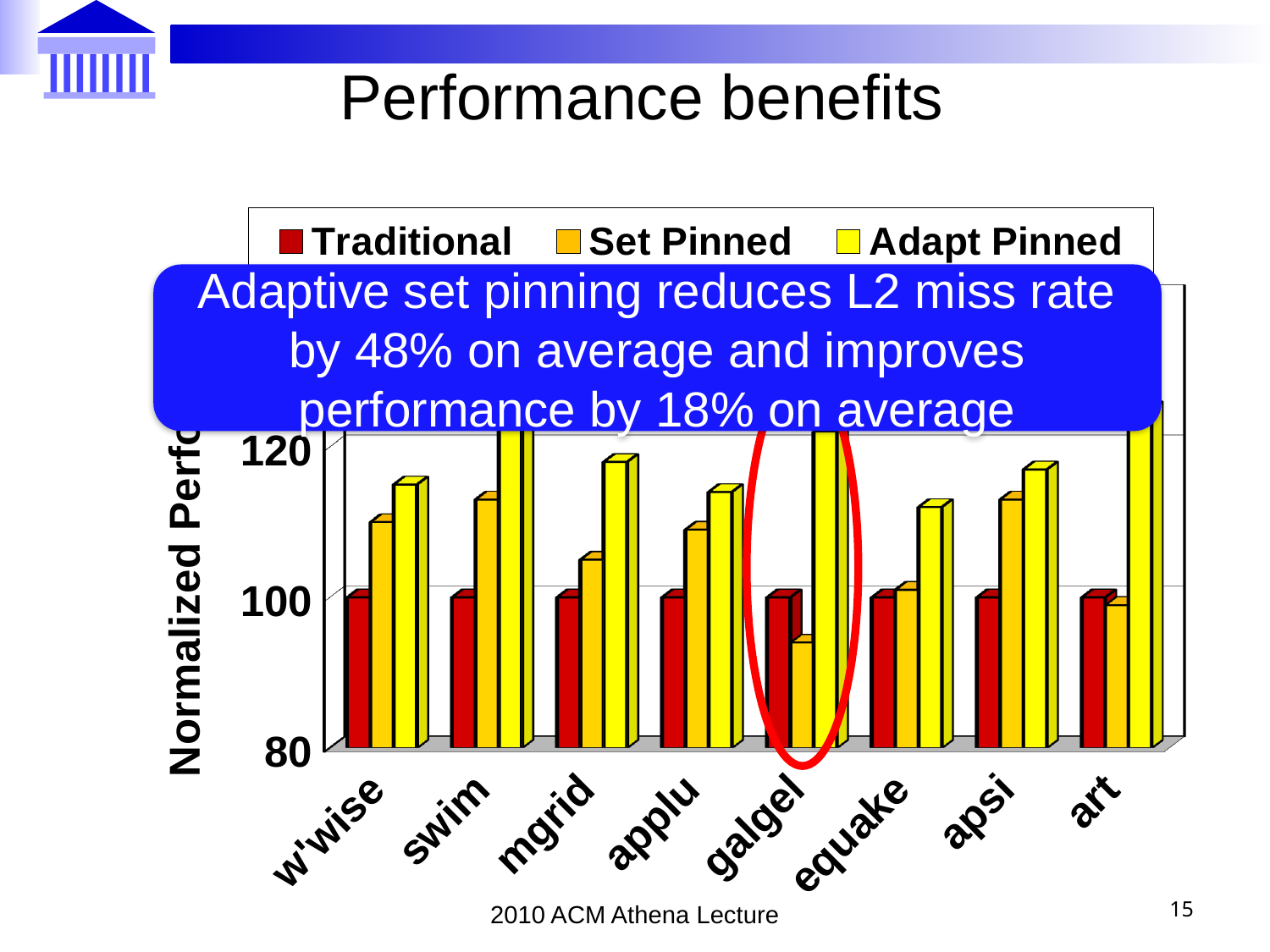
Is the Adapt Pinned value for applu greater or less than 120? less What colour are the Traditional bars? red For galgel, which is larger: the Traditional value or the Set Pinned value? Traditional Which category has the lowest Set Pinned value? galgel What kind of chart is shown on the slide? bar chart What are the three series named in the legend? Traditional, Set Pinned, Adapt Pinned What is the Traditional value for w'wise? 100 Is the Set Pinned value for galgel greater or less than 100? less How many benchmark categories are shown on the x axis? 8 How many series does the legend list? 3 For w'wise, which is larger: the Set Pinned value or the Adapt Pinned value? Adapt Pinned Is the Set Pinned value for w'wise greater or less than 100? greater